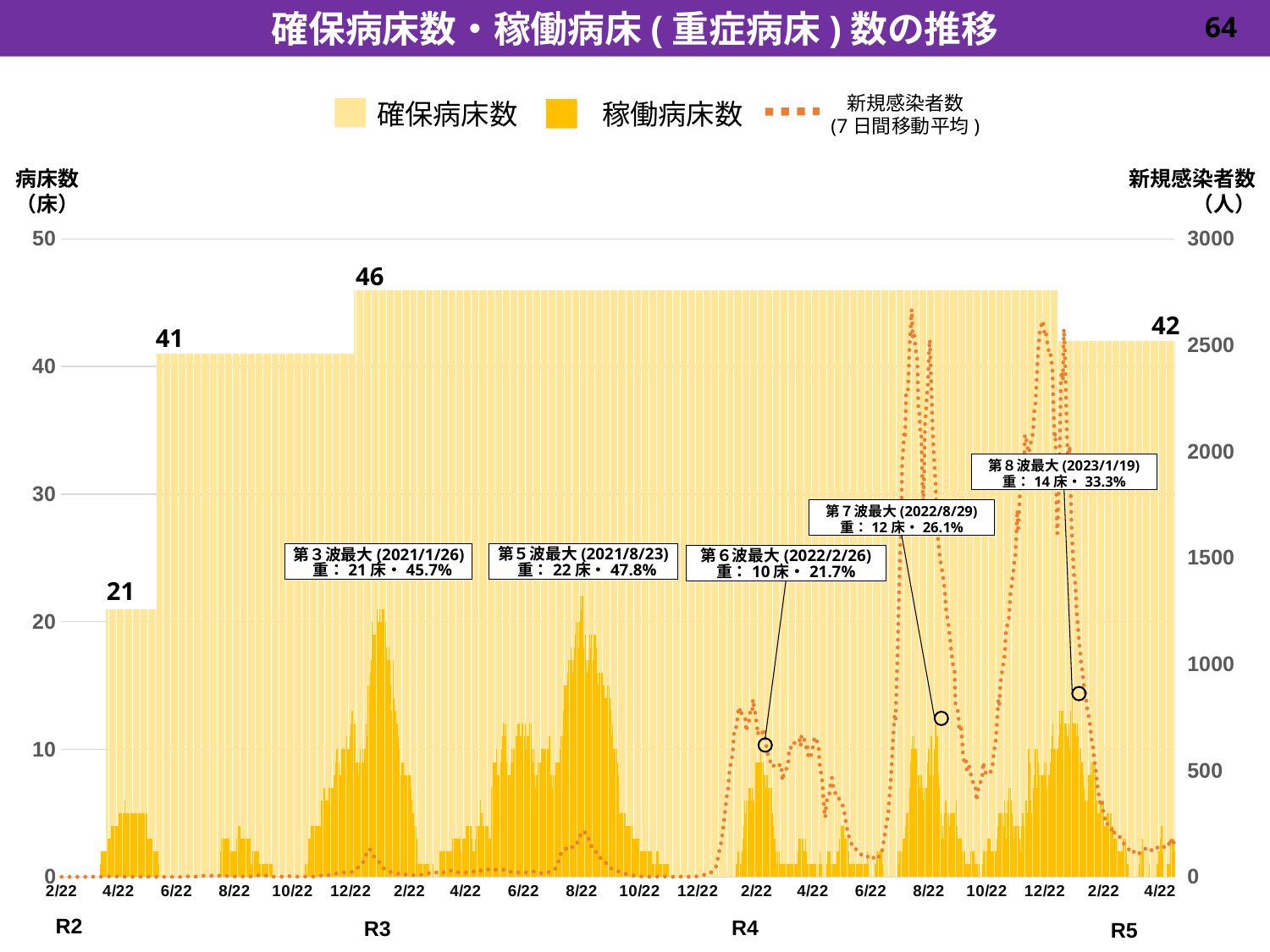
What is the highest labelled value of 確保病床数 (secured beds) shown on the chart? 46 According to the annotation, how many 重症病床 were in use at the 第3波 maximum (2021/1/26)? 21床 According to the annotation, how many 重症病床 were in use at the 第8波 maximum (2023/1/19)? 14床 What is the title of the chart on the slide? 確保病床数・稼働病床(重症病床)数の推移 According to the annotation, what percentage is given for the 第5波 maximum (2021/8/23)? 47.8% What is the labelled value of 確保病床数 at the right end of the chart (R5)? 42 What is the lowest labelled value of 確保病床数 (secured beds) shown on the chart? 21 What is the difference in 重症病床 between the 第5波 maximum (22床) and the 第6波 maximum (10床)? 12床 Is the peak of the 新規感染者数 dotted line around 8/22 in R4 greater or less than 2500 on the right axis? greater Which wave maximum had more 重症病床 in use: 第6波 (2022/2/26) or 第7波 (2022/8/29)? 第7波 (2022/8/29) How many series does the chart legend list? 3 What is the difference between the labelled 確保病床数 values 46 and 41? 5